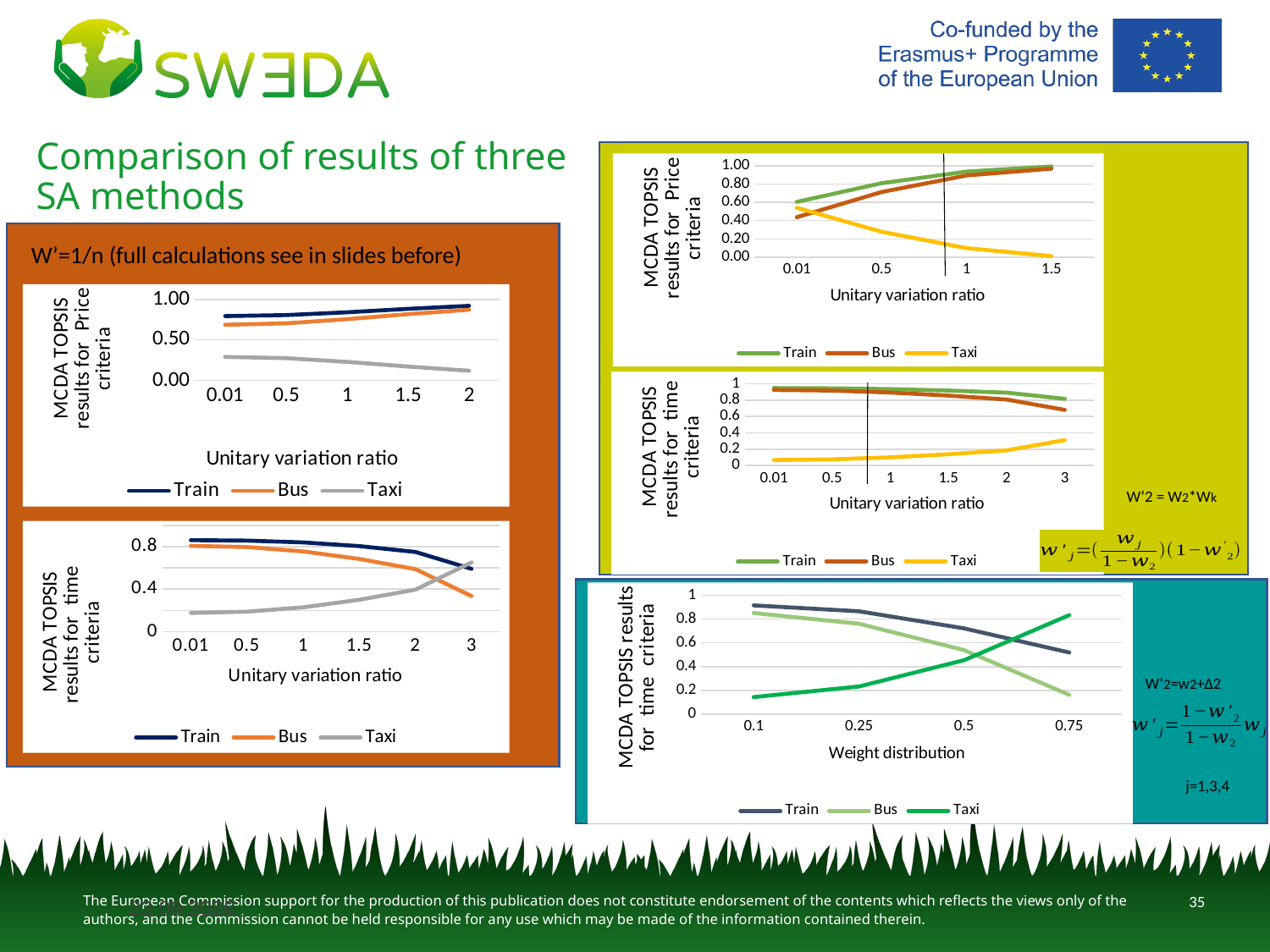
In the top-right chart (Price criteria, x-axis 0.01 to 1.5), is the value for Taxi at a unitary variation ratio of 1.5 greater or less than 0.20? less In the top-left chart (Price criteria, x-axis 0.01 to 2), which series has the lowest value at a unitary variation ratio of 2? Taxi In the middle-right chart (time criteria, x-axis 0.01 to 3), which series has the lowest value at a unitary variation ratio of 0.01? Taxi What kind of chart is the top-left chart (MCDA TOPSIS results for Price criteria, x-axis 0.01 to 2)? line chart How many series does the legend of the top-left chart (Price criteria, x-axis 0.01 to 2) list? 3 In the bottom-left chart (time criteria, x-axis 0.01 to 3), does the Taxi series rise or fall as the unitary variation ratio increases? rise What is the x-axis title of the bottom-right chart? Weight distribution How many points are on the x-axis of the top-left chart (Price criteria, x-axis 0.01 to 2)? 5 In the top-left chart (Price criteria, x-axis 0.01 to 2), does the Taxi series rise or fall as the unitary variation ratio increases? fall In the bottom-left chart (time criteria, x-axis 0.01 to 3), is the value for Train at a unitary variation ratio of 0.01 greater or less than 0.4? greater How many points are on the x-axis of the top-right chart (Price criteria, x-axis 0.01 to 1.5)? 4 In the bottom-right chart (x-axis Weight distribution), which is larger at a weight distribution of 0.75: Train or Bus? Train